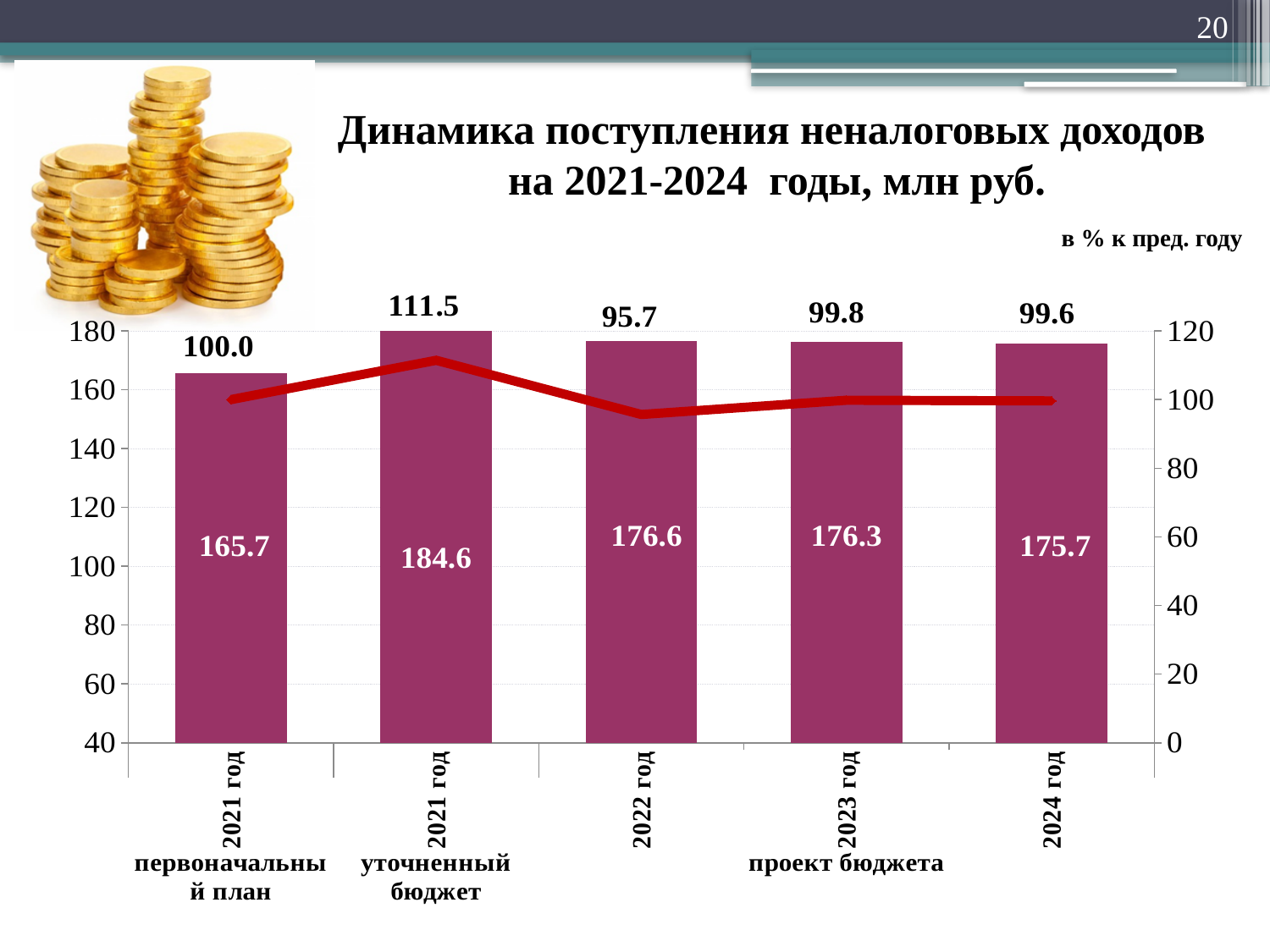
What is the title of the chart? Динамика поступления неналоговых доходов на 2021-2024 годы, млн руб. Which is larger, the bar value for 2022 год or for 2023 год? 2022 год What is the value of the bar for 2024 год? 175.7 How many bars are plotted in the chart? 5 What is the difference between the bar values for 2021 год (уточненный бюджет) and 2021 год (первоначальный план)? 18.9 Which category has the highest bar value? 2021 год (уточненный бюджет) What is the value of the line (в % к пред. году) for 2021 год (первоначальный план)? 100.0 Which category has the lowest line value (в % к пред. году)? 2022 год Which category has the lowest bar value? 2021 год (первоначальный план) What kind of chart is shown on the slide? Combined bar and line chart What is the value of the line (в % к пред. году) for 2022 год? 95.7 What is the value of the bar for 2021 год (уточненный бюджет)? 184.6